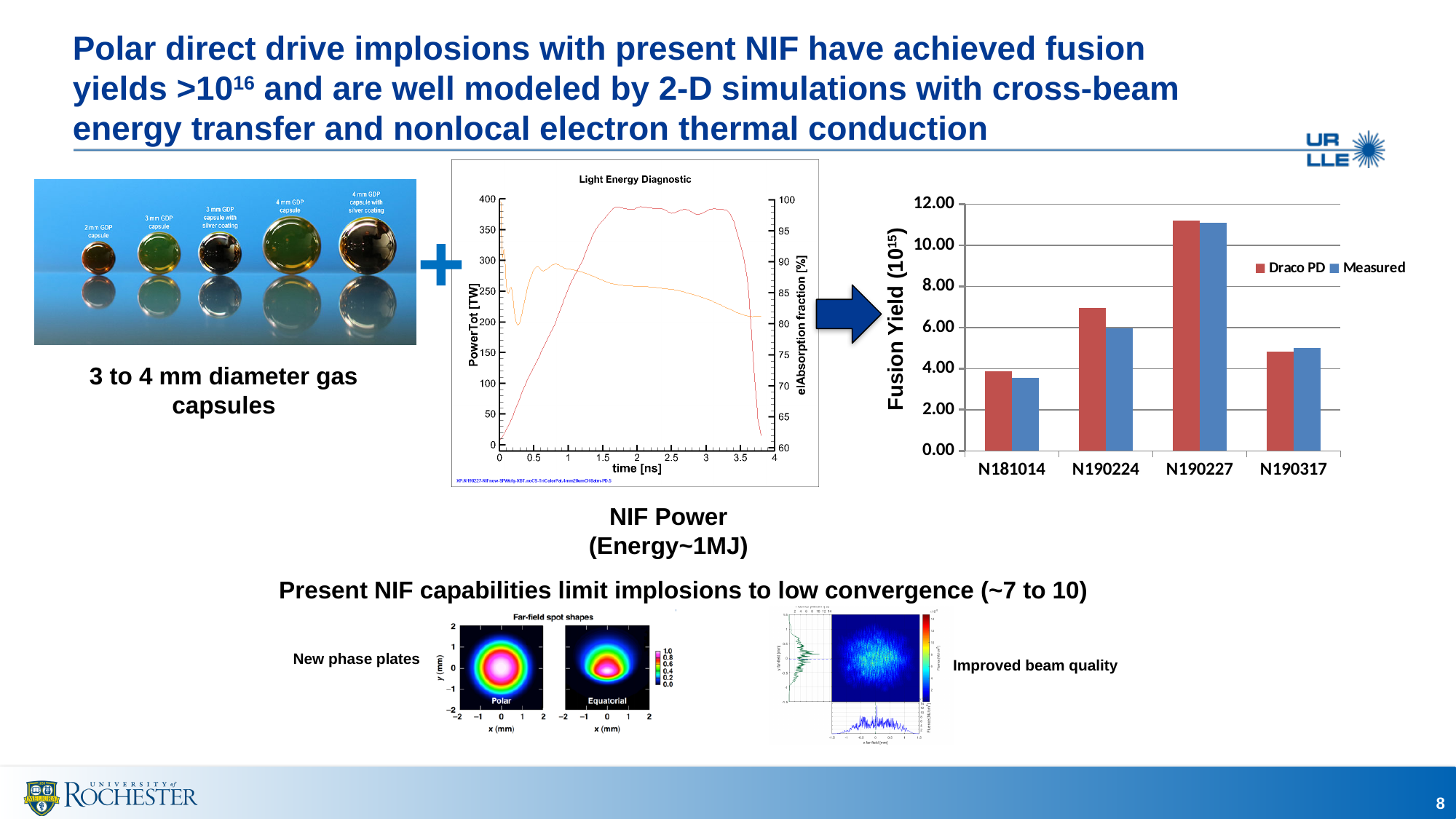
In the Fusion Yield bar chart, for shot N190224, which is larger: the Draco PD value or the Measured value? Draco PD What is the title of the line chart in the middle of the slide? Light Energy Diagnostic How many series does the legend of the Fusion Yield chart list? 2 In the Fusion Yield bar chart, which shot has the lowest Measured fusion yield? N181014 In the Fusion Yield bar chart, is the Measured value for N181014 greater or less than 4.00? less In the Fusion Yield bar chart, which shot has the highest Draco PD fusion yield? N190227 How many shots (categories) are shown on the x axis of the Fusion Yield bar chart? 4 What is the y-axis label of the Fusion Yield bar chart? Fusion Yield (10^15) In the Fusion Yield bar chart, is the Draco PD value for N190224 greater or less than 6.00? greater What kind of chart is the Fusion Yield chart on the right of the slide? Bar chart In the Fusion Yield bar chart, is the Measured value for N190227 greater or less than 10.00? greater